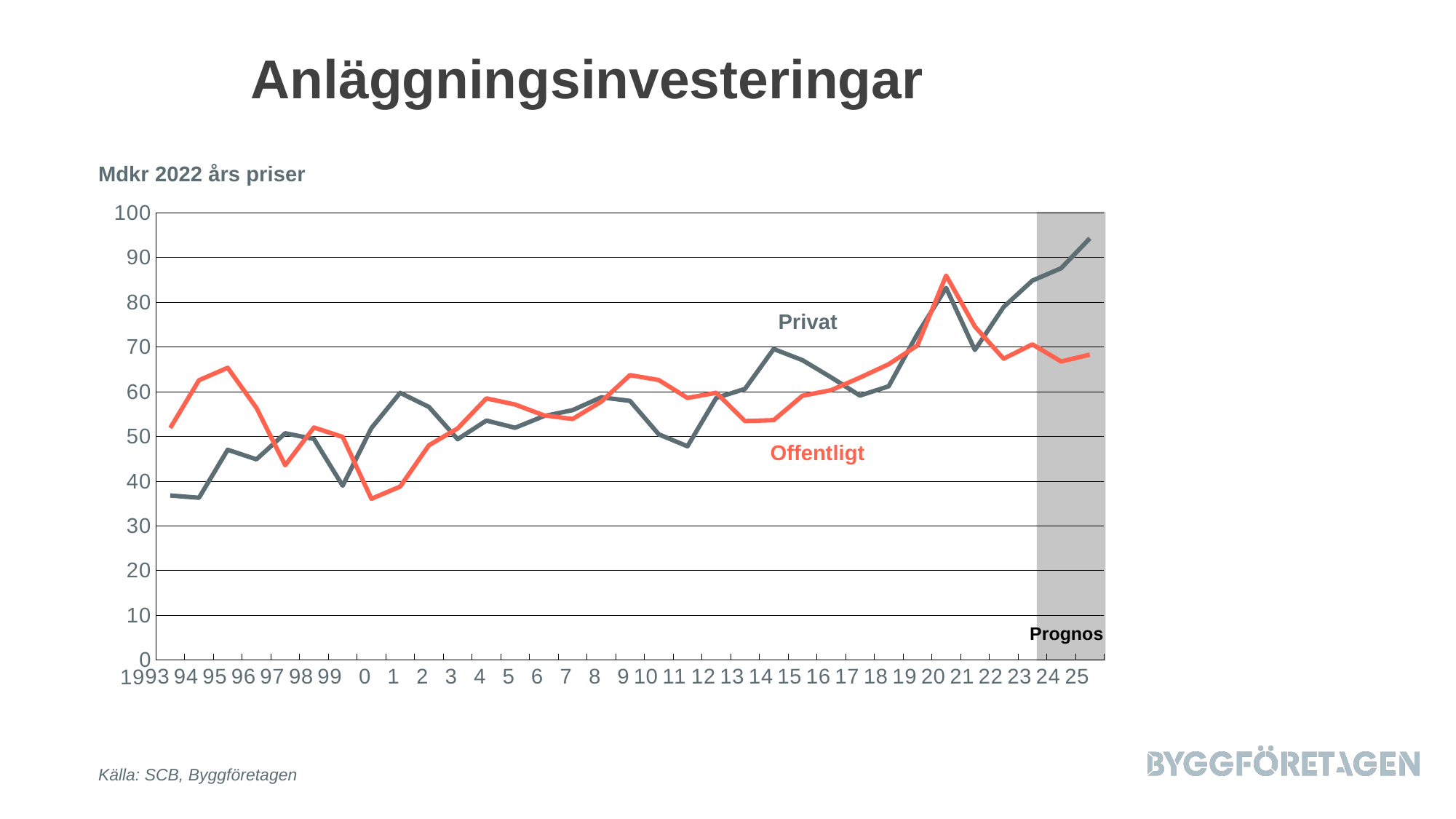
Is the value for Offentligt in 0 (2000) greater or less than 40? less Is the value for Offentligt in 20 greater or less than 80? greater What unit is given above the chart? Mdkr 2022 års priser How many series are plotted in the chart? 2 What kind of chart is shown on the slide? Line chart In 95, which series has the higher value, Privat or Offentligt? Offentligt What are the names of the two series in the chart? Privat and Offentligt Is the value for Privat in 25 greater or less than 90? greater In which year does the Offentligt series reach its highest value? 20 In 25, which series has the higher value, Privat or Offentligt? Privat Does the Privat series rise or fall from 21 to 25? Rise